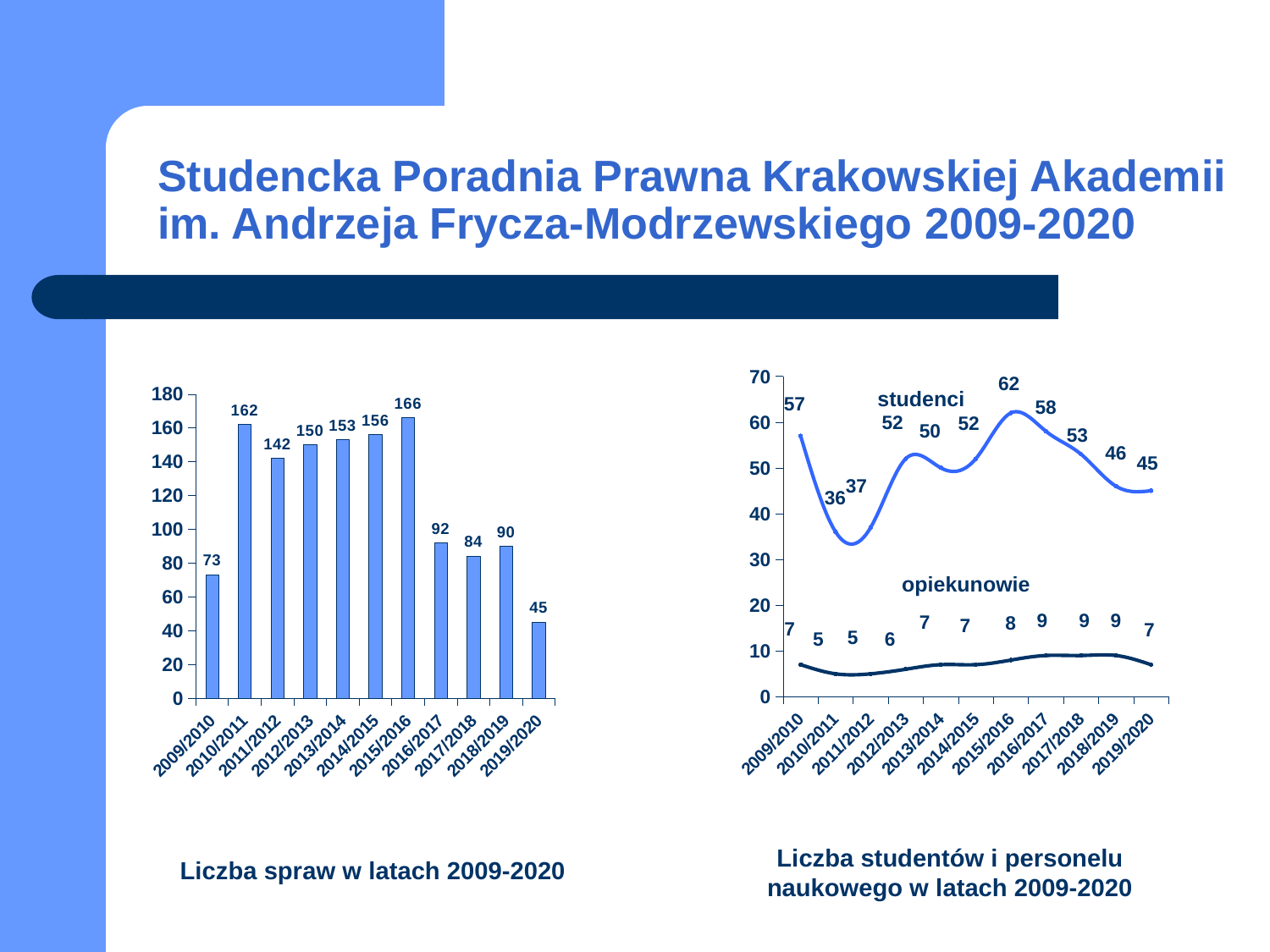
What kind of chart is the right chart (Liczba studentów i personelu naukowego)? line chart In the left chart (Liczba spraw w latach 2009-2020), which year has the lowest value? 2019/2020 In the left chart (Liczba spraw w latach 2009-2020), which year has the highest value? 2015/2016 What kind of chart is the left chart (Liczba spraw w latach 2009-2020)? bar chart In the right chart (Liczba studentów i personelu naukowego), what is the difference between studenci and opiekunowie in 2016/2017? 49 In the right chart (Liczba studentów i personelu naukowego), what is the value for opiekunowie in 2012/2013? 6 In the left chart (Liczba spraw w latach 2009-2020), what is the value for 2015/2016? 166 In the right chart (Liczba studentów i personelu naukowego), which is larger: studenci in 2009/2010 or studenci in 2019/2020? 2009/2010 In the left chart (Liczba spraw w latach 2009-2020), what is the difference between the values for 2010/2011 and 2009/2010? 89 In the right chart (Liczba studentów i personelu naukowego), what is the value for studenci in 2015/2016? 62 In the left chart (Liczba spraw w latach 2009-2020), how many years are shown on the x axis? 11 In the right chart (Liczba studentów i personelu naukowego), in which year is the studenci value lowest? 2010/2011